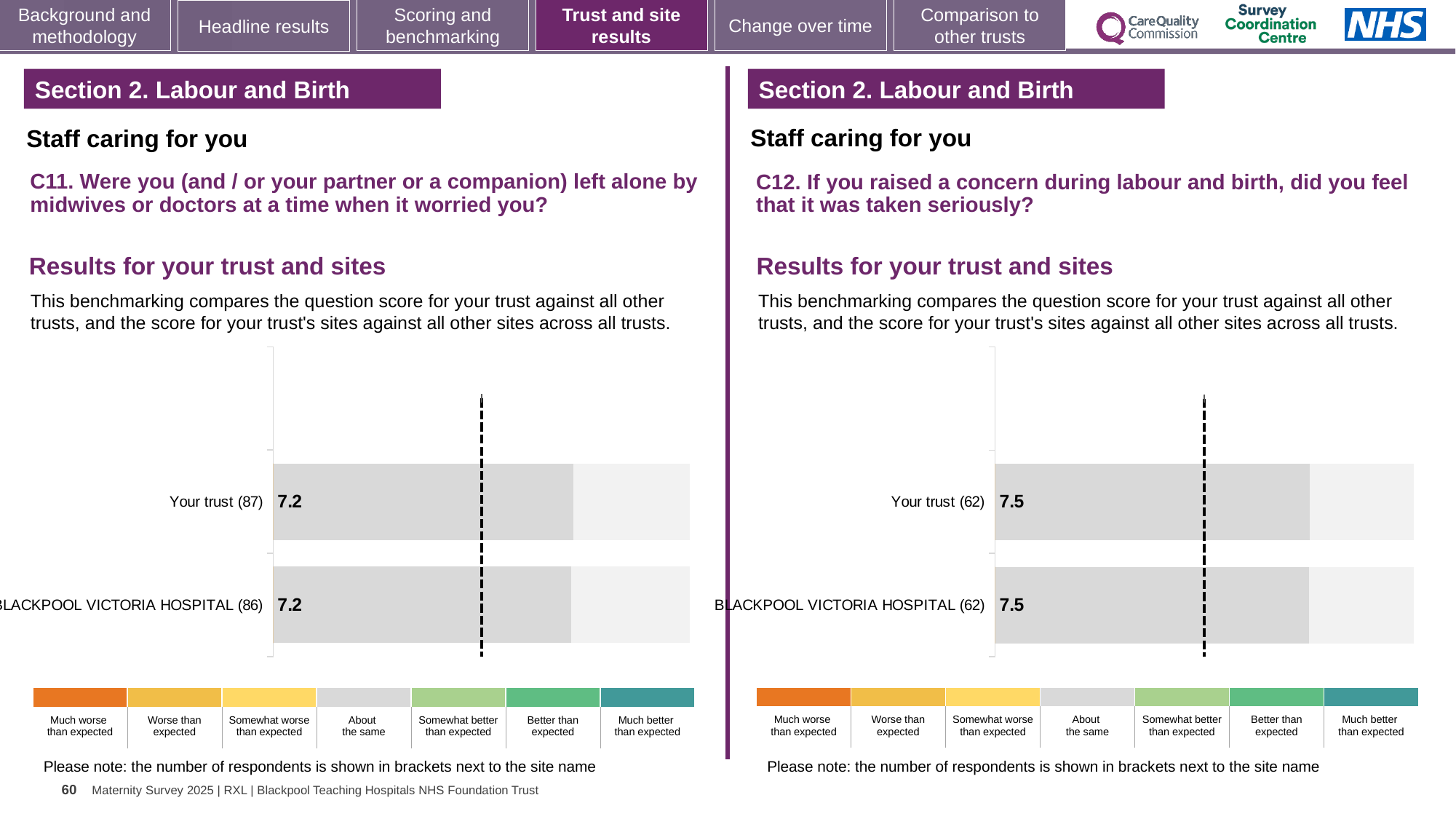
In the C11 chart on the left, how many respondents are shown in brackets for Your trust? 87 How many categories does the colour legend below the C12 chart on the right list? 7 In the C11 chart on the left, what is the difference between the Your trust score and the BLACKPOOL VICTORIA HOSPITAL score? 0 How many bars are plotted in the C12 chart on the right? 2 In the C12 chart on the right, what is the difference between the Your trust score and the BLACKPOOL VICTORIA HOSPITAL score? 0 How many bars are plotted in the C11 chart on the left? 2 In the C11 chart on the left, what is the score for Your trust? 7.2 In the C12 chart on the right, what is the score for BLACKPOOL VICTORIA HOSPITAL? 7.5 In the C11 chart on the left, what is the score for BLACKPOOL VICTORIA HOSPITAL? 7.2 What kind of chart is used for the C11 results on the left? Bar chart In the C12 chart on the right, how many respondents are shown in brackets for BLACKPOOL VICTORIA HOSPITAL? 62 In the C12 chart on the right, what is the score for Your trust? 7.5